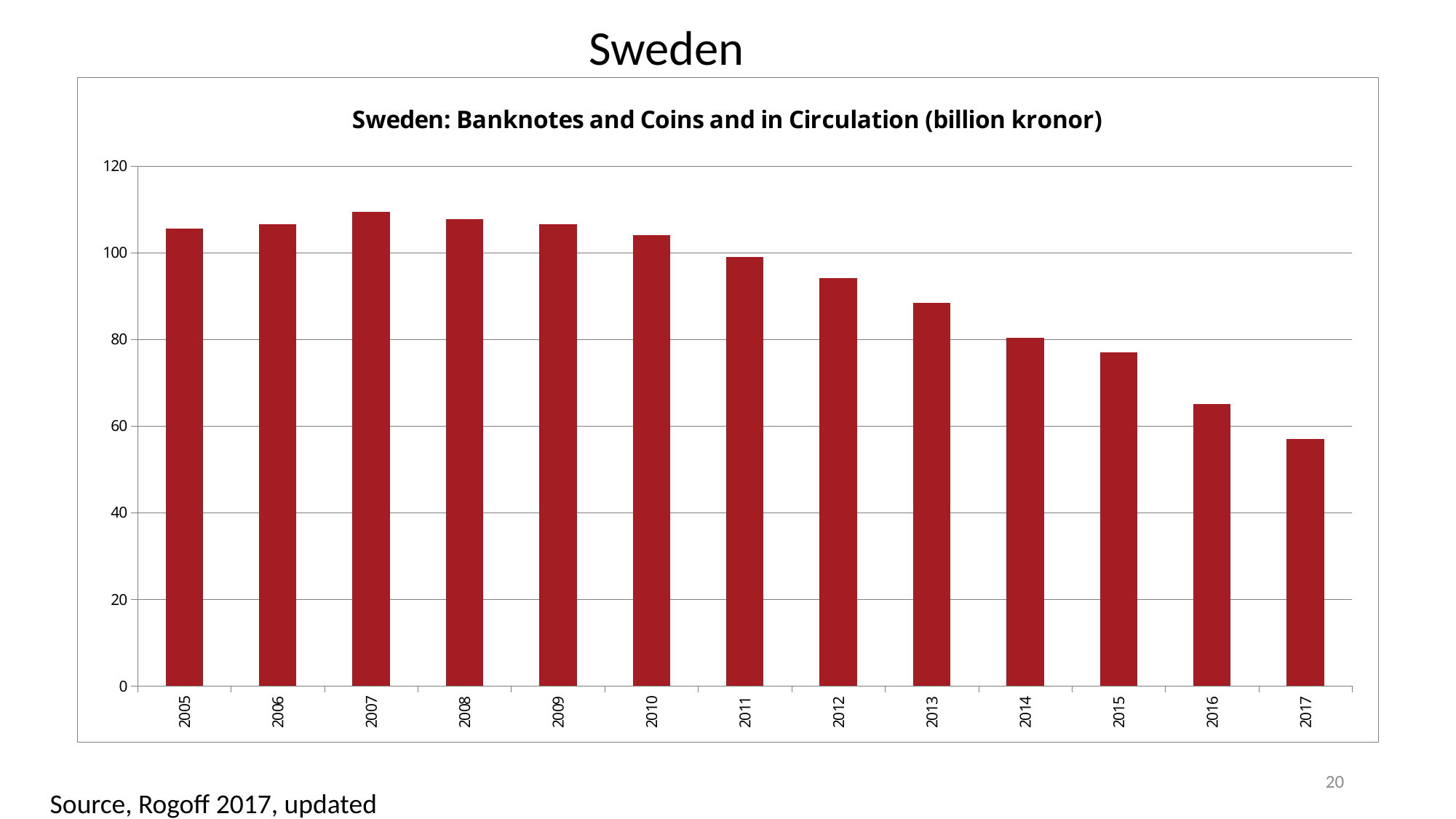
What is the title of the chart? Sweden: Banknotes and Coins and in Circulation (billion kronor) Is the value for 2017 greater or less than 60? less Which year has the lowest value? 2017 Is the value for 2012 greater or less than 100? less Is the value for 2015 greater or less than 80? less What colour are the bars in the chart? dark red How many years are plotted on the chart? 13 Which year has the highest value? 2007 What kind of chart is shown on the slide? bar chart Which is larger, the value for 2013 or the value for 2016? 2013 Do the values generally rise or fall from 2007 to 2017? fall